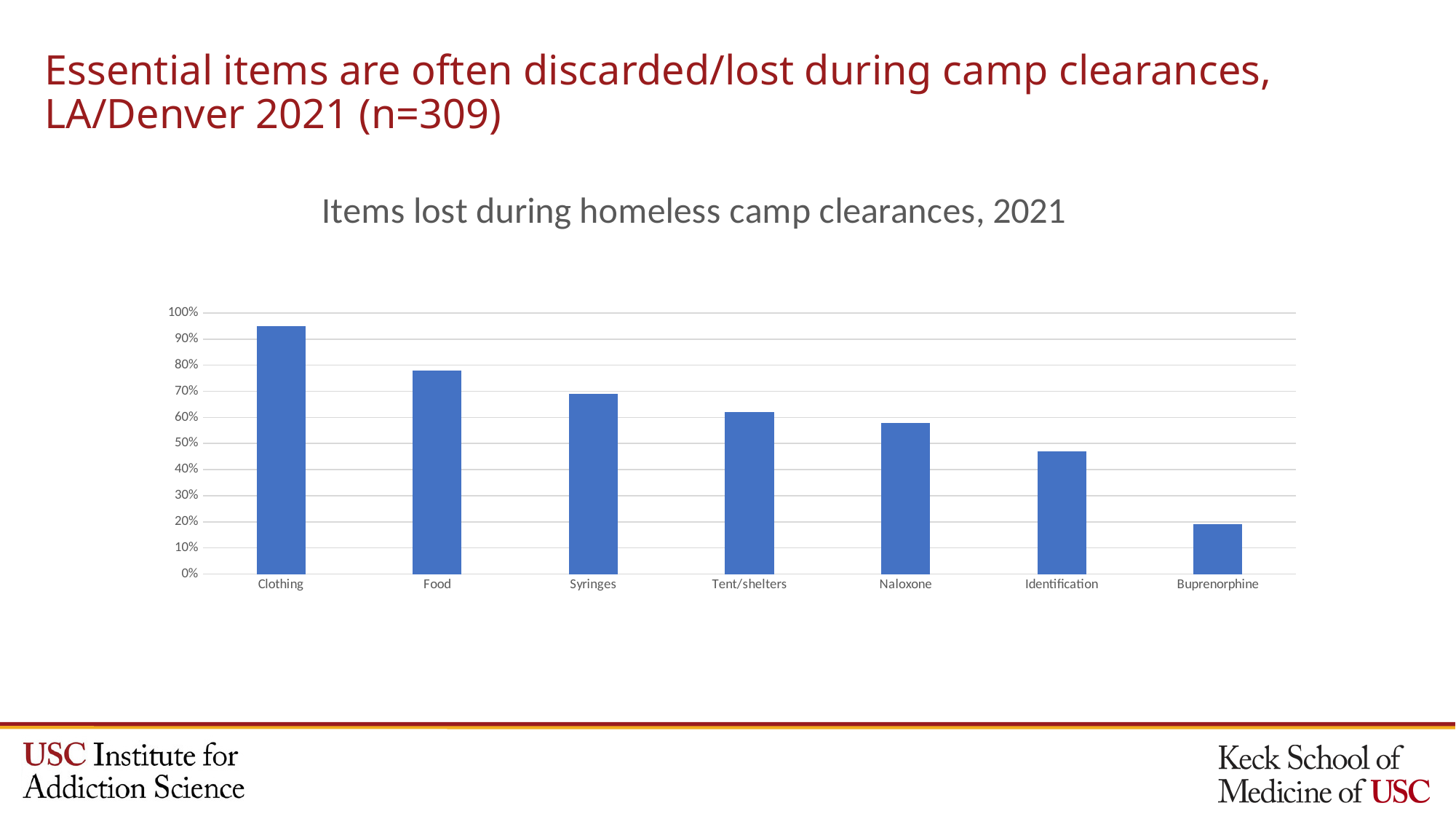
Which is larger, the value for Syringes or the value for Naloxone? Syringes Which item has the highest percentage lost during camp clearances? Clothing Is the value for Food greater or less than 70%? greater Do the bar values rise or fall moving from left to right across the x axis? Fall What type of chart is shown on the slide? Bar chart What is the title of the chart? Items lost during homeless camp clearances, 2021 Is the value for Clothing greater or less than 90%? greater Is the value for Identification greater or less than 50%? less How many item categories are shown on the x axis of the chart? 7 Which item has the lowest percentage lost during camp clearances? Buprenorphine